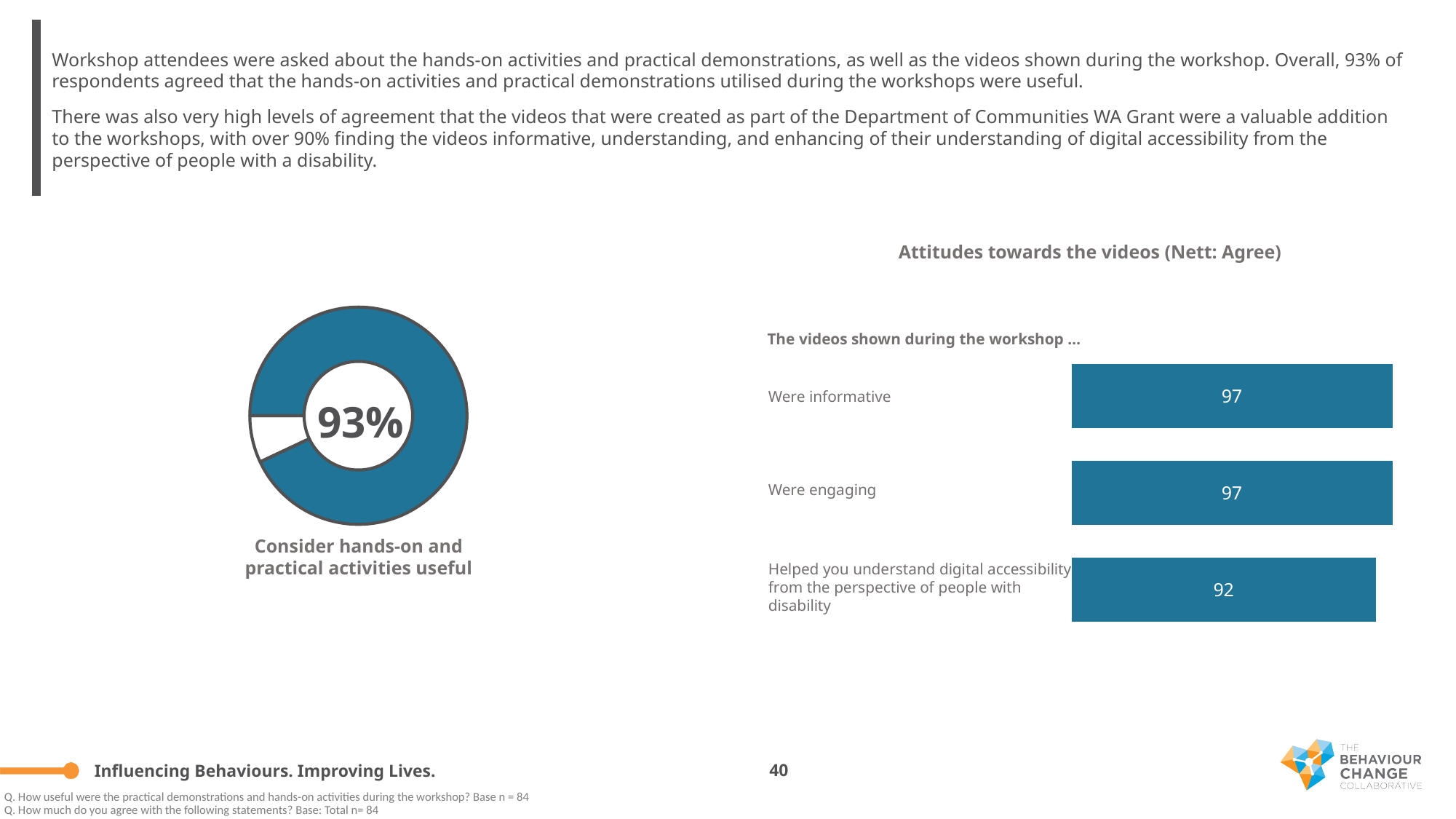
What is the title of the bar chart on the right of the slide? Attitudes towards the videos (Nett: Agree) In the 'Attitudes towards the videos (Nett: Agree)' chart, what is the value for 'Were engaging'? 97 In the 'Attitudes towards the videos (Nett: Agree)' chart, do the values for 'Were informative' and 'Were engaging' have the same value? Yes In the chart on the left of the slide, what percentage consider hands-on and practical activities useful? 93% In the 'Attitudes towards the videos (Nett: Agree)' chart, which statement has the lowest value? Helped you understand digital accessibility from the perspective of people with disability In the 'Attitudes towards the videos (Nett: Agree)' chart, what is the value for 'Helped you understand digital accessibility from the perspective of people with disability'? 92 In the 'Attitudes towards the videos (Nett: Agree)' chart, what is the value for 'Were informative'? 97 What kind of chart is the chart on the left of the slide, labelled 'Consider hands-on and practical activities useful'? Donut chart How many statements are shown in the 'Attitudes towards the videos (Nett: Agree)' chart? 3 In the 'Attitudes towards the videos (Nett: Agree)' chart, which is larger: the value for 'Were engaging' or the value for 'Helped you understand digital accessibility from the perspective of people with disability'? Were engaging In the 'Attitudes towards the videos (Nett: Agree)' chart, what is the difference between the values for 'Were informative' and 'Helped you understand digital accessibility from the perspective of people with disability'? 5 What kind of chart is the 'Attitudes towards the videos (Nett: Agree)' chart? Bar chart